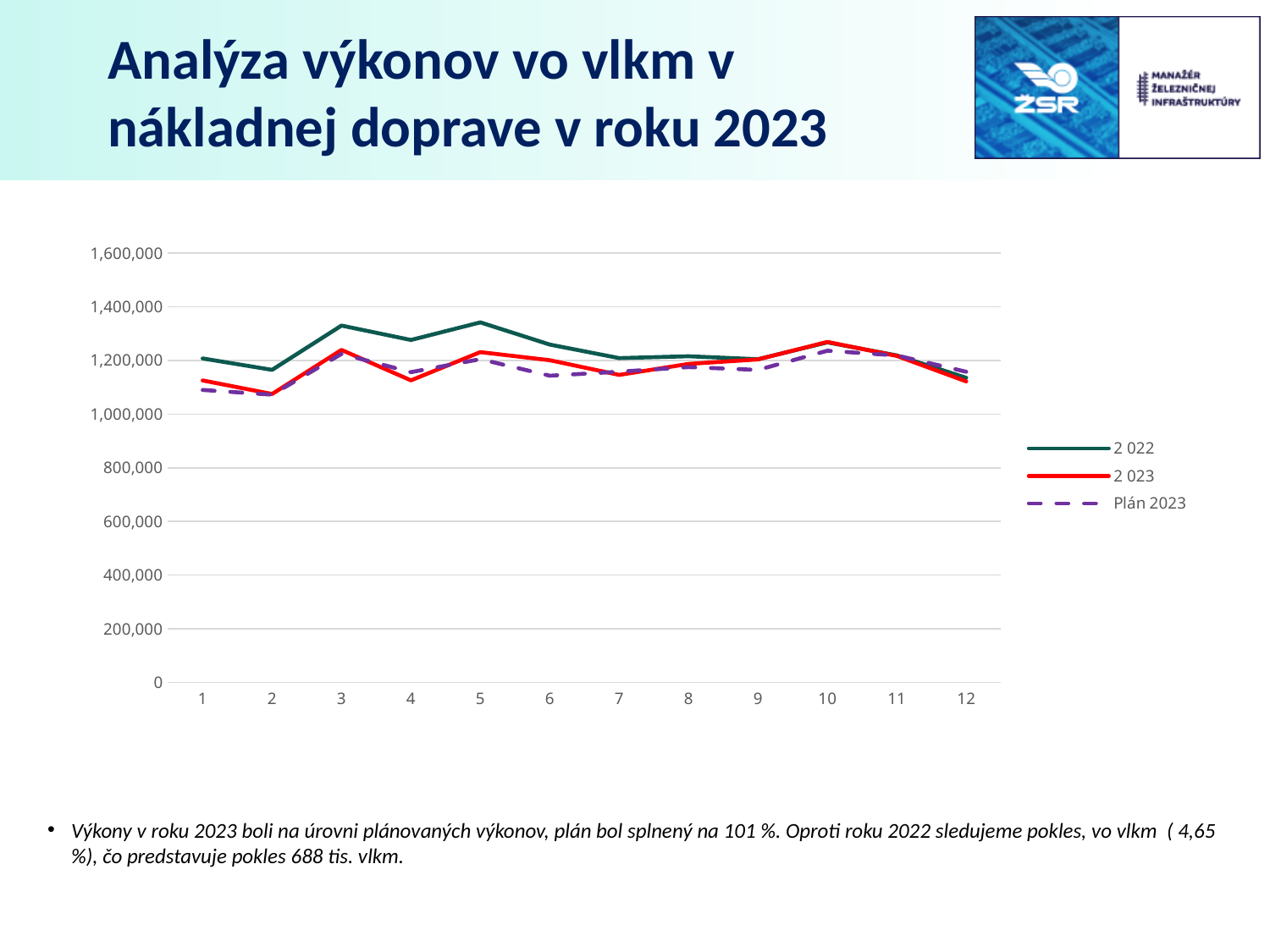
How many series does the legend list? 3 At point 3, which series has the larger value, 2 022 or 2 023? 2 022 What kind of chart is shown on the slide? line chart What are the three entries in the legend? 2 022, 2 023, Plán 2023 Which series is drawn with a dashed line? Plán 2023 At which point does the 2 023 series reach its lowest value? 2 How many points are plotted along the x axis for each series? 12 Is the value for the 2 023 series at point 10 greater or less than 1,200,000? greater Is the value for the Plán 2023 series at point 1 greater or less than 1,200,000? less Is the value for the 2 023 series at point 2 greater or less than 1,200,000? less Do the values of the 2 023 series rise or fall from point 10 to point 12? fall